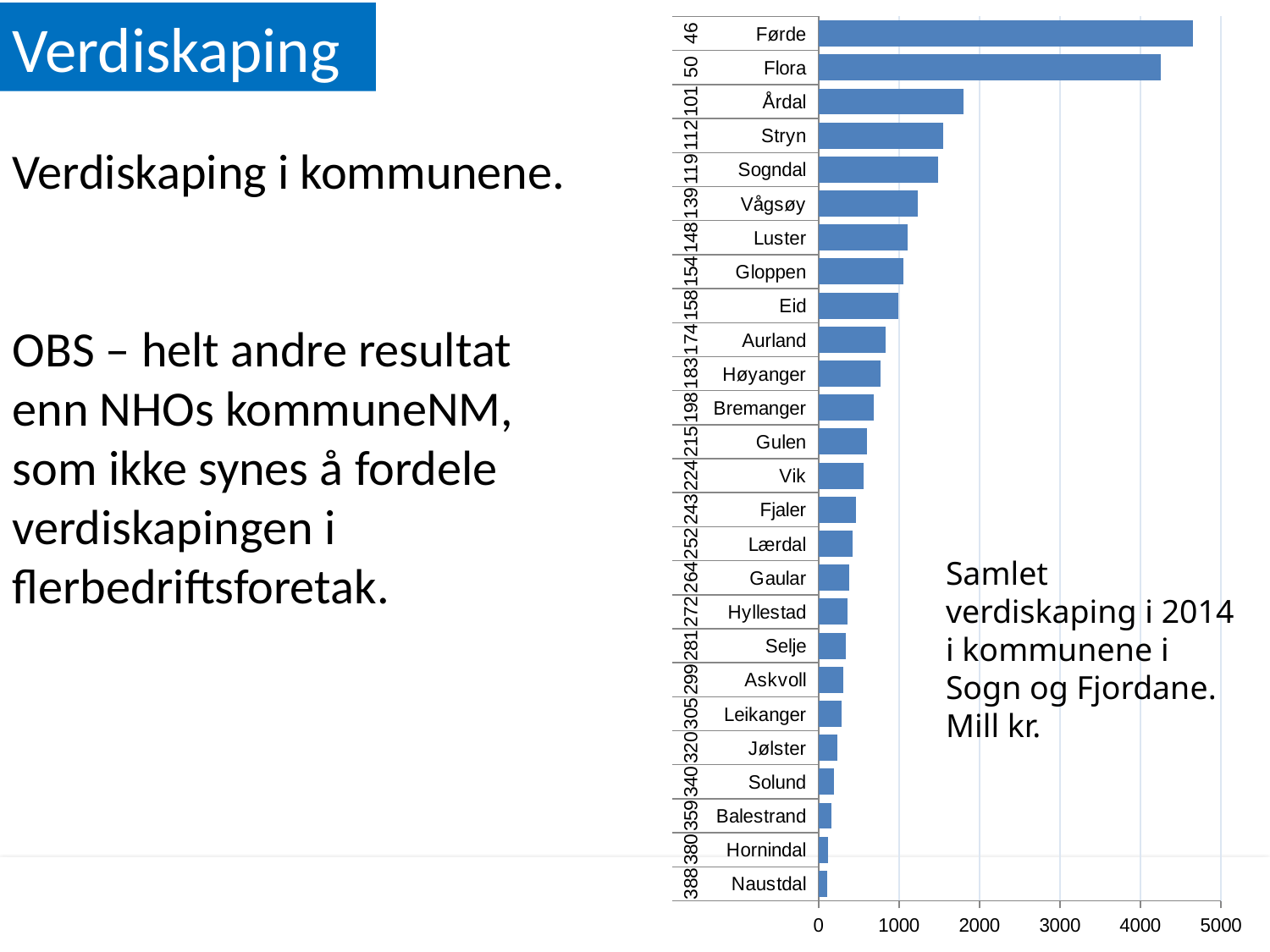
How many municipalities are plotted in the chart? 26 Is the value for Årdal greater or less than 2000? less What number is printed to the left of Førde in the chart? 46 Which municipality has the highest value in the chart? Førde Which has the larger value, Årdal or Stryn? Årdal Is the value for Aurland greater or less than 1000? less Which has the larger value, Førde or Flora? Førde According to the text next to the chart, in what unit are the values given? Mill kr. Do the bar values increase or decrease going from the top of the chart to the bottom? decrease What kind of chart is shown on the slide? bar chart Is the value for Flora greater or less than 4000? greater